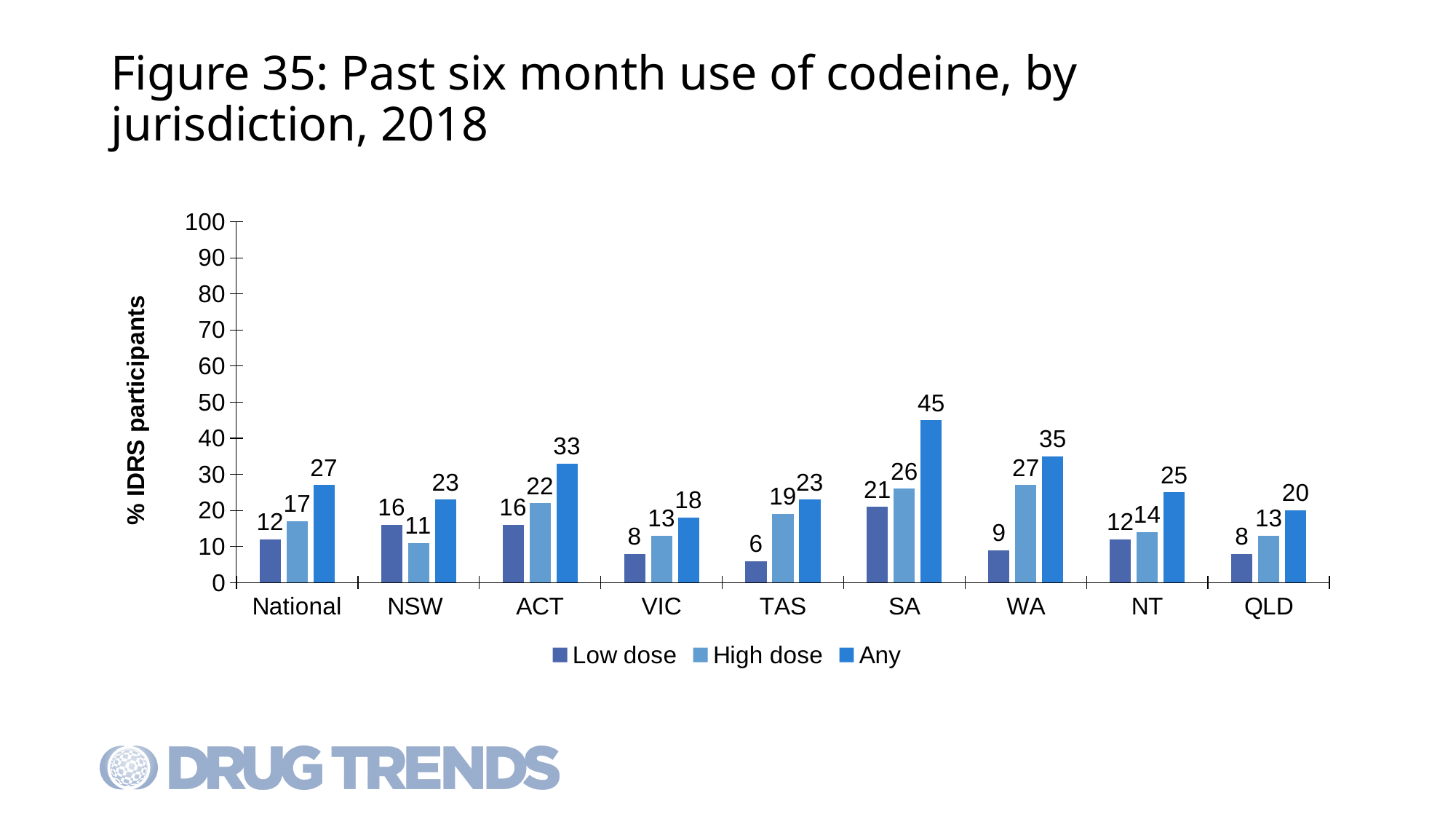
What is the Low dose value for TAS? 6 How many series does the legend list? 3 What is the value for Any codeine use in SA? 45 How many jurisdictions (categories) are shown on the x axis? 9 What is the label of the y axis? % IDRS participants What is the High dose value for WA? 27 Which jurisdiction has the lowest Low dose value? TAS What is the difference between the Any value for SA and the Any value for National? 18 Which jurisdiction has the highest value for Any codeine use? SA What are the three series listed in the legend? Low dose, High dose, Any What kind of chart is shown on the slide? Bar chart Which is larger, the Low dose value for NSW or the High dose value for NSW? Low dose